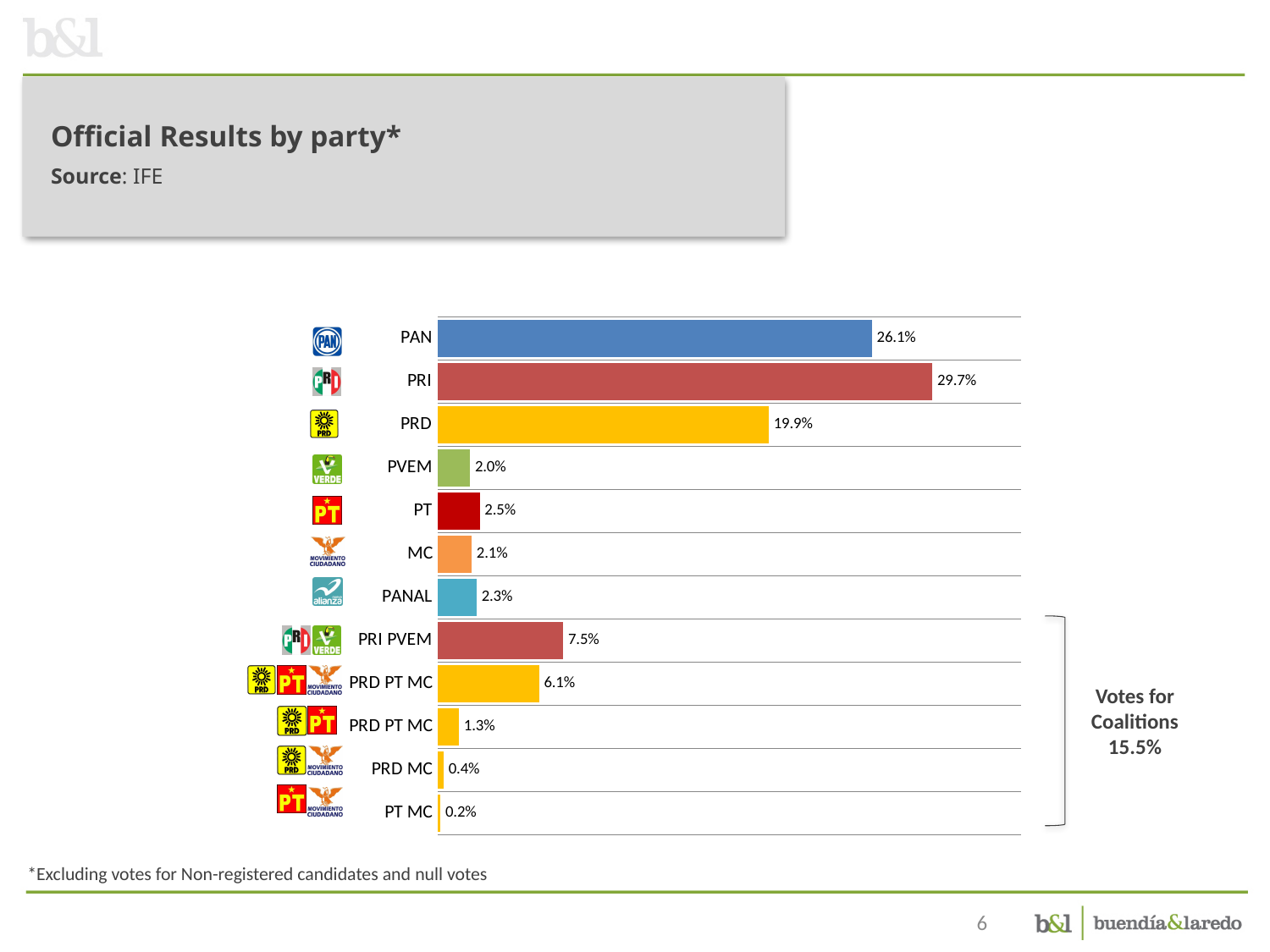
Which category has the lowest value in the chart? PT MC According to the annotation on the right, what is the total share of votes for coalitions? 15.5% Which received a larger share of votes, PT or PVEM? PT What type of chart is shown on the slide? Bar chart What percentage of votes did PRI receive? 29.7% What percentage is shown for PRD? 19.9% What is the value for the PRI PVEM coalition? 7.5% What is the value shown for PAN? 26.1% What percentage is shown for PANAL? 2.3% How many categories (bars) are shown in the chart? 12 What is the difference between the PRI and PAN percentages? 3.6% Which party has the highest share of votes? PRI